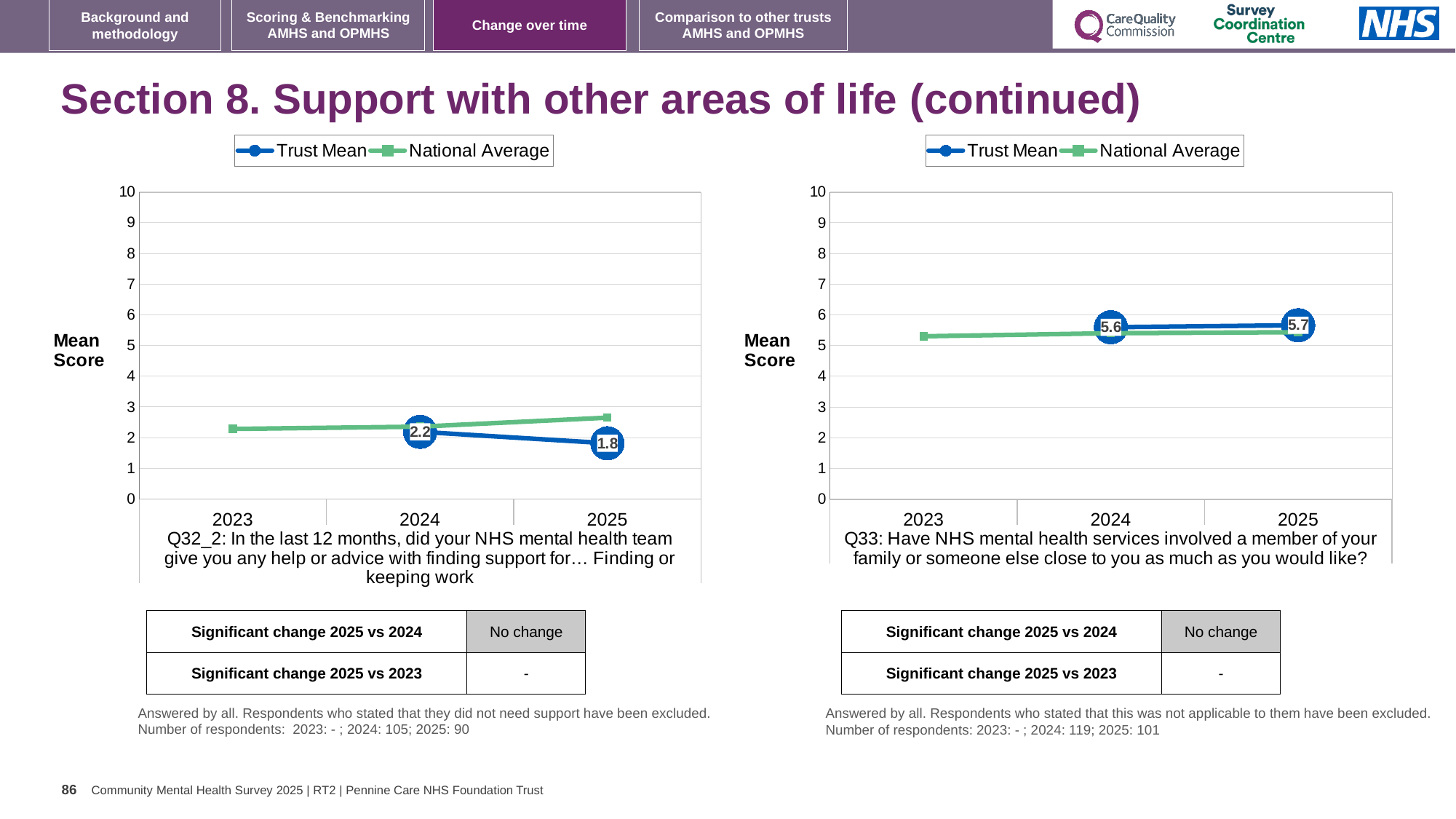
How many series does the legend of the right chart (Q33) list? 2 On the right chart (Q33), what is the Trust Mean value for 2025? 5.7 What type of chart is the left chart (Q32_2)? line chart On the left chart (Q32_2), what is the Trust Mean value for 2024? 2.2 On the left chart (Q32_2), what is the Trust Mean value for 2025? 1.8 On the left chart (Q32_2), is the National Average for 2025 greater or less than 2? greater On the right chart (Q33), does the National Average rise or fall from 2023 to 2025? rise On the right chart (Q33), what is the Trust Mean value for 2024? 5.6 On the left chart (Q32_2), by how much did the Trust Mean change from 2024 to 2025? 0.4 On the right chart (Q33), is the National Average for 2023 greater or less than 6? less On the right chart (Q33), what is the difference between the Trust Mean in 2025 and in 2024? 0.1 On the left chart (Q32_2), does the Trust Mean rise or fall from 2024 to 2025? fall